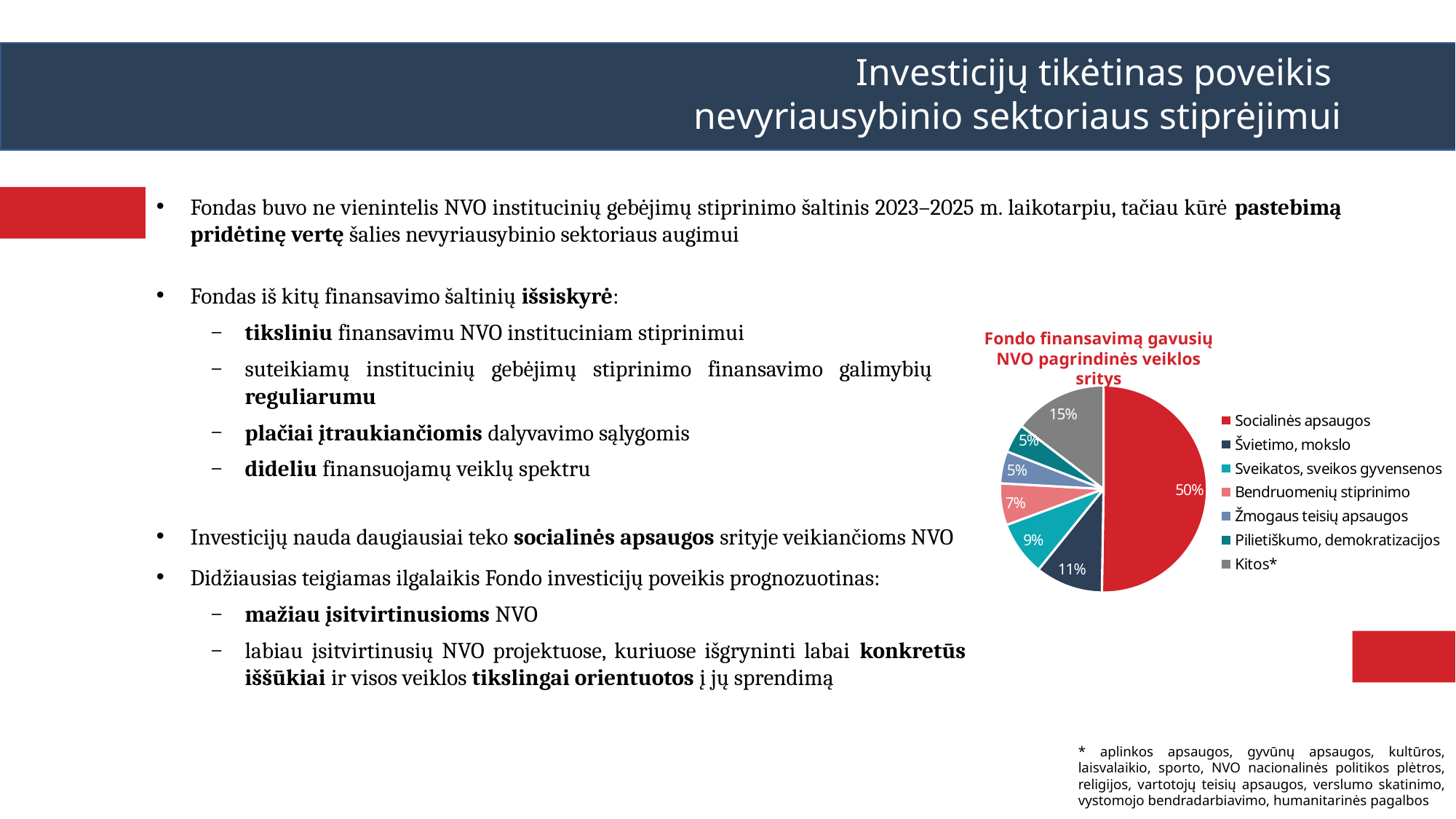
Which is larger, Švietimo, mokslo or Sveikatos, sveikos gyvensenos? Švietimo, mokslo How many slices does the pie chart have? 7 How many entries does the legend list? 7 What percentage is shown for Bendruomenių stiprinimo? 7% What type of chart is shown on the slide? Pie chart What is the title of the chart? Fondo finansavimą gavusių NVO pagrindinės veiklos sritys Which category has the largest slice of the pie? Socialinės apsaugos What is the difference in percentage points between Socialinės apsaugos and Kitos*? 35 What share does the Kitos* slice have? 15% What share of the pie does Socialinės apsaugos hold? 50% What is the value for Sveikatos, sveikos gyvensenos? 9% What percentage is shown for Švietimo, mokslo? 11%